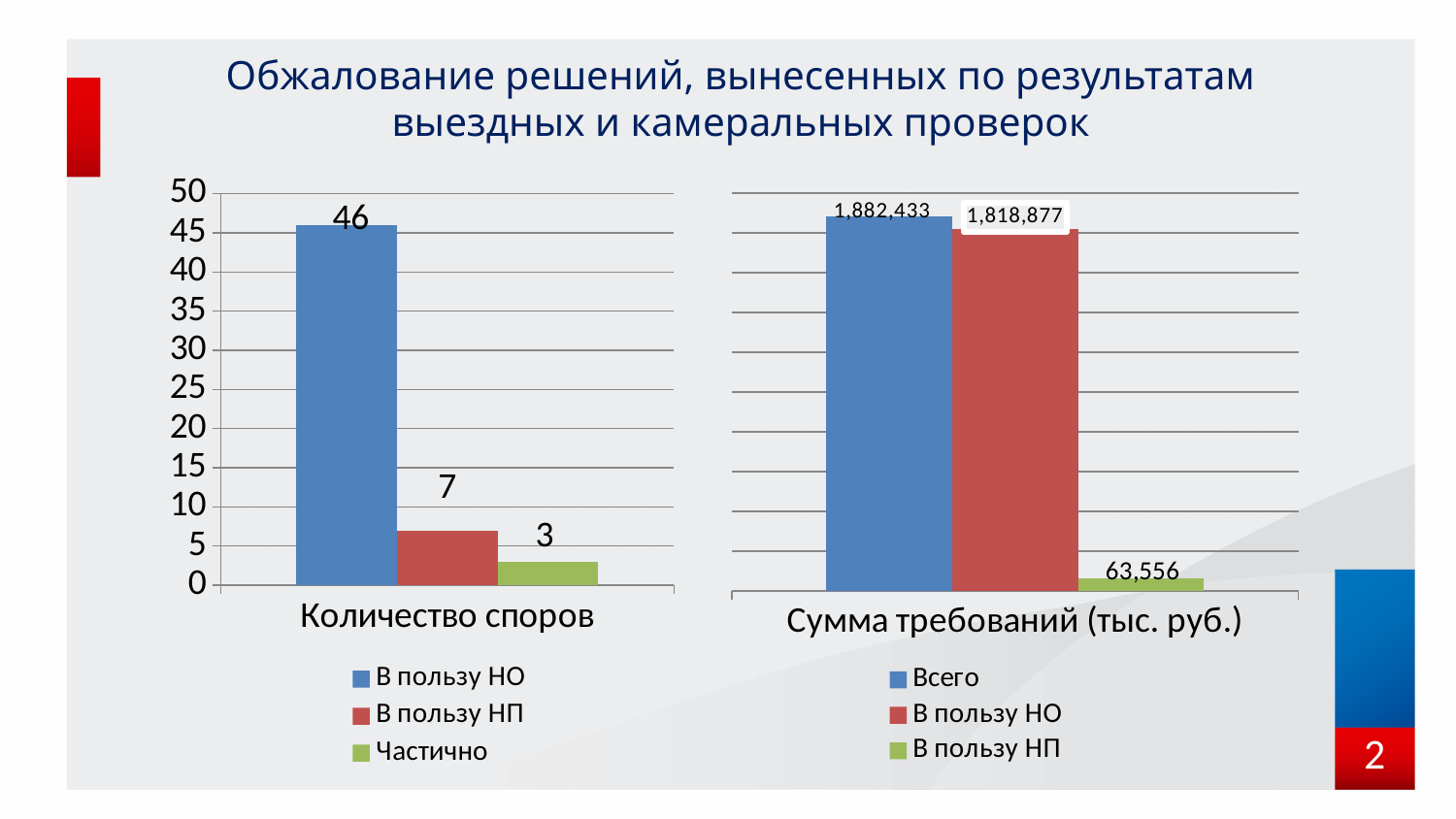
In the right chart (Сумма требований (тыс. руб.)), which series has the highest value? Всего In the right chart (Сумма требований (тыс. руб.)), what is the value for В пользу НП? 63,556 In the right chart (Сумма требований (тыс. руб.)), what is the difference between Всего and В пользу НО? 63,556 In the left chart (Количество споров), how many series does the legend list? 3 In the left chart (Количество споров), what is the value for Частично? 3 In the right chart (Сумма требований (тыс. руб.)), which is larger: В пользу НО or В пользу НП? В пользу НО In the left chart (Количество споров), is the value for В пользу НП greater or less than 10? less What type of chart is the left chart (Количество споров)? bar chart In the right chart (Сумма требований (тыс. руб.)), what is the value for Всего? 1,882,433 In the left chart (Количество споров), what is the difference between В пользу НО and В пользу НП? 39 In the left chart (Количество споров), which series has the lowest value? Частично In the left chart (Количество споров), what is the value for В пользу НО? 46